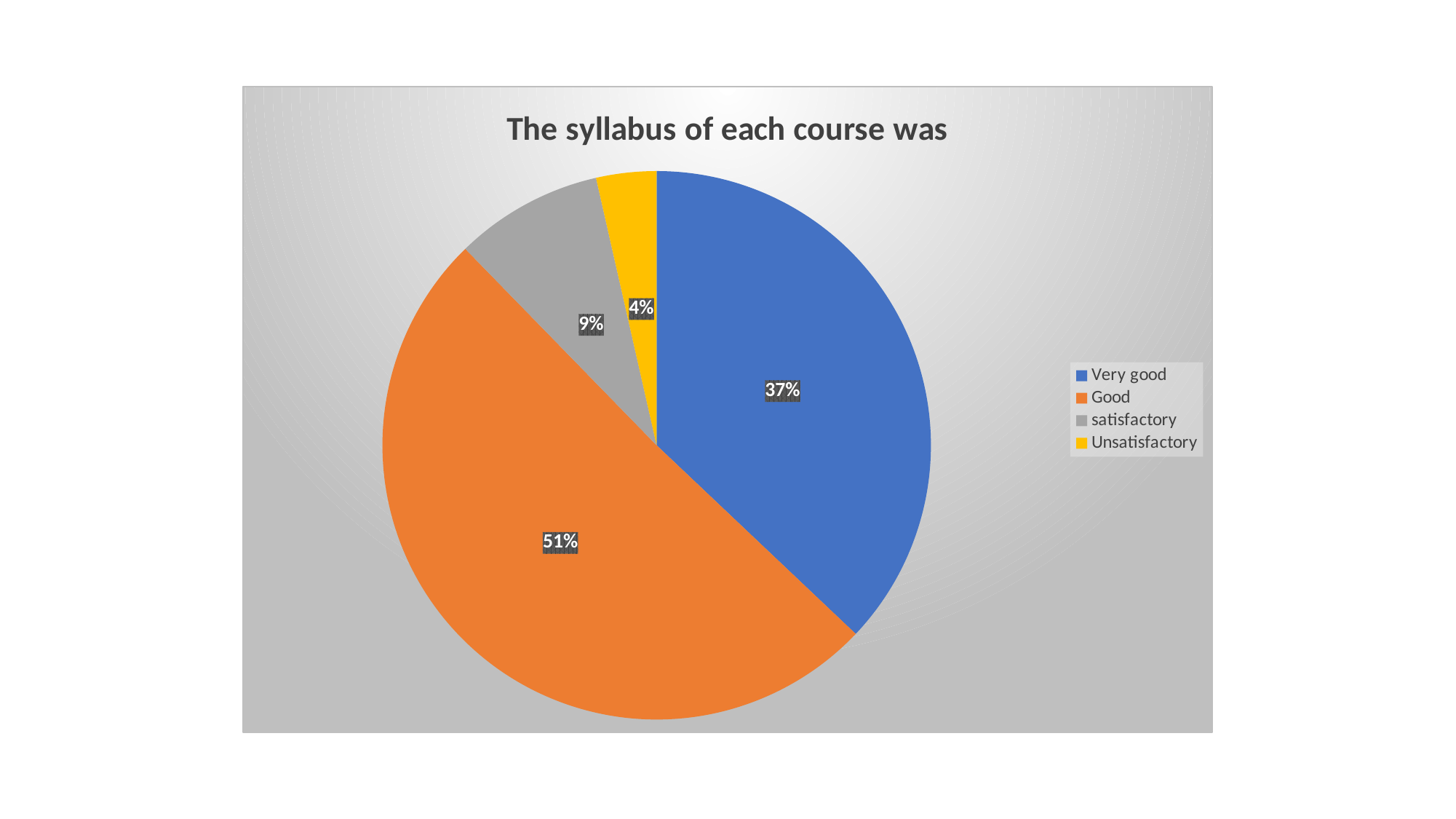
What is the value shown for "Very good"? 37% Which is larger, the share for "satisfactory" or the share for "Unsatisfactory"? satisfactory What is the title of the chart? The syllabus of each course was What is the difference in percentage points between "Good" and "Very good"? 14 Which category has the smallest slice of the pie? Unsatisfactory What share of the pie does "Good" represent? 51% What colour is the slice for "Good"? Orange Which category has the largest slice of the pie? Good How many categories are shown in the pie chart? 4 What percentage is shown for "satisfactory"? 9% What percentage is shown for "Unsatisfactory"? 4% What kind of chart is shown on the slide? Pie chart